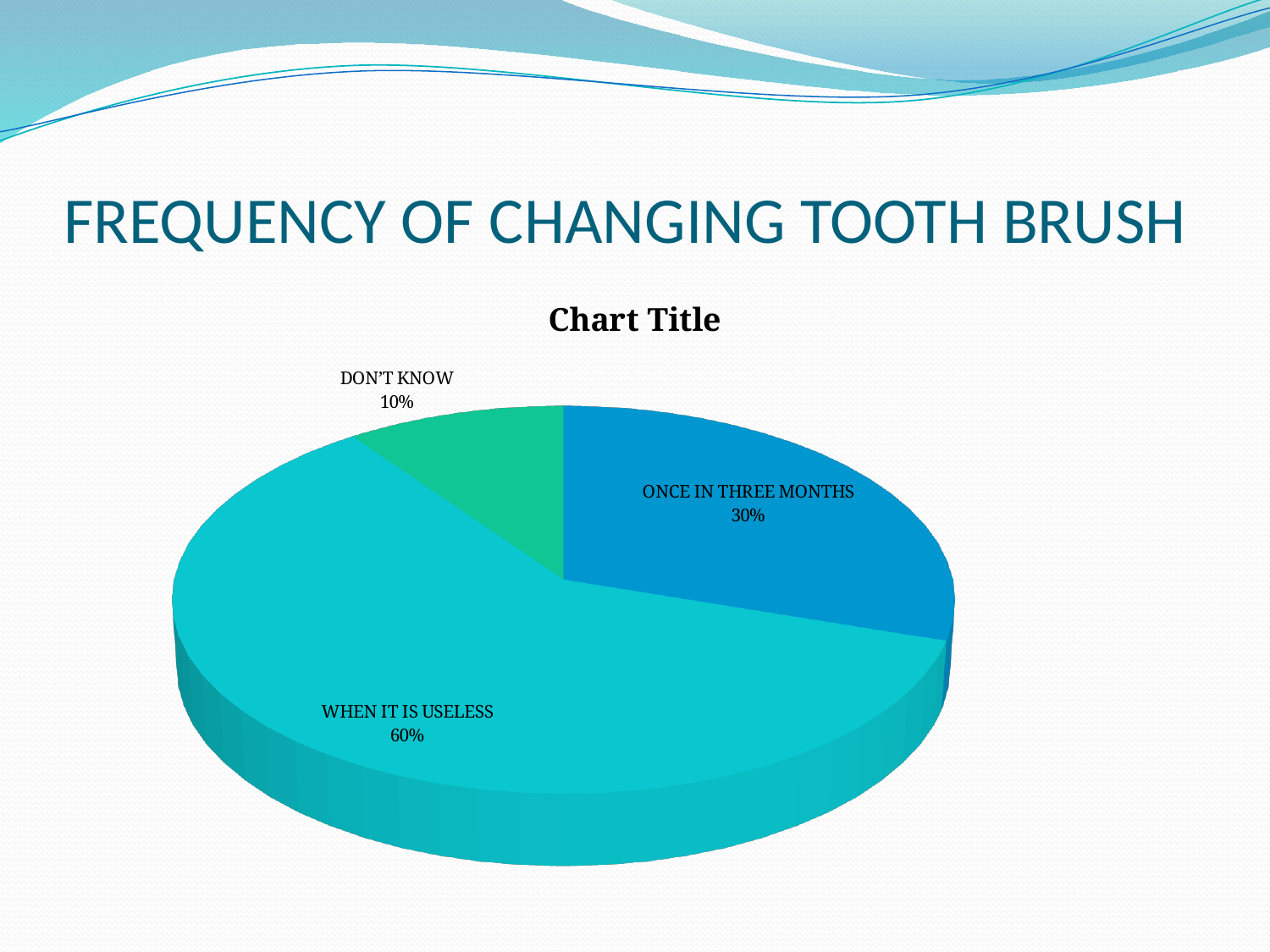
What is the difference in percentage points between 'When it is useless' and 'Once in three months'? 30 Which category has the smallest share of the pie? DON'T KNOW What percentage of respondents change their toothbrush when it is useless? 60% What percentage of respondents answered 'Don't know'? 10% What colour is the slice for 'Don't know'? Green Which is larger: the share for 'Once in three months' or the share for 'Don't know'? ONCE IN THREE MONTHS Which category has the largest share of the pie? WHEN IT IS USELESS What percentage of respondents change their toothbrush once in three months? 30% What is the difference in percentage points between 'Once in three months' and 'Don't know'? 20 What is the title printed above the pie chart? Chart Title How many categories are shown in the pie chart? 3 What kind of chart is shown on the slide? Pie chart